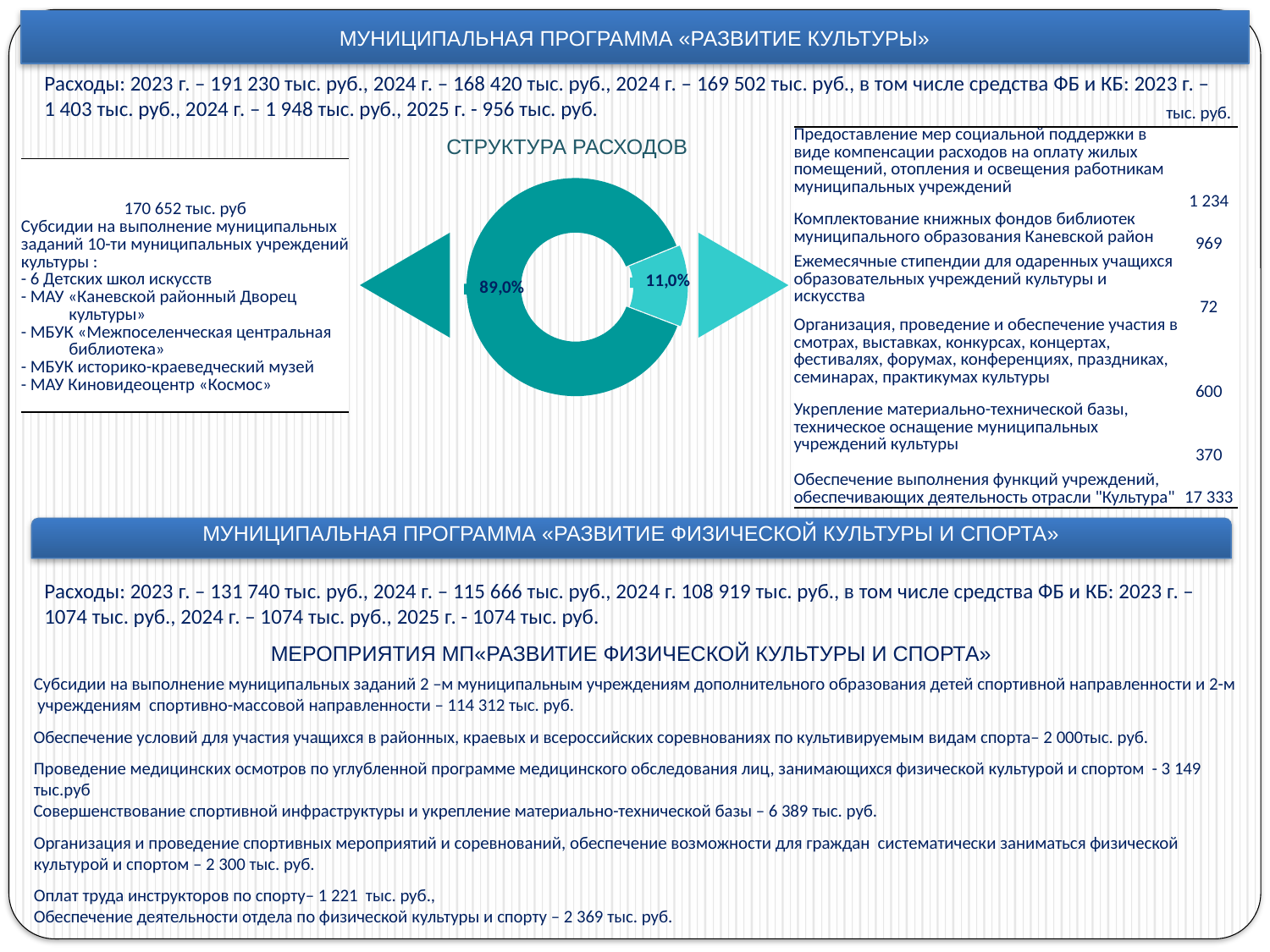
What is the value of the smallest slice in the «СТРУКТУРА РАСХОДОВ» chart? 11,0% What is the title of the chart on the slide? СТРУКТУРА РАСХОДОВ What kind of chart is shown under the title «СТРУКТУРА РАСХОДОВ»? Doughnut chart What colour is the slice labelled 89,0% in the «СТРУКТУРА РАСХОДОВ» chart? Dark teal In the «СТРУКТУРА РАСХОДОВ» chart, which slice is larger: the dark teal one or the light teal one? The dark teal one (89,0%) What do the two slices of the «СТРУКТУРА РАСХОДОВ» chart add up to? 100,0% Is the larger slice of the «СТРУКТУРА РАСХОДОВ» chart greater or less than 80%? greater How many slices does the «СТРУКТУРА РАСХОДОВ» chart have? 2 What is the value of the largest slice in the «СТРУКТУРА РАСХОДОВ» chart? 89,0% Is the smaller slice of the «СТРУКТУРА РАСХОДОВ» chart greater or less than 20%? less What share of the «СТРУКТУРА РАСХОДОВ» chart does the light teal slice represent? 11,0% In the «СТРУКТУРА РАСХОДОВ» chart, what is the difference between the two slice values? 78,0%